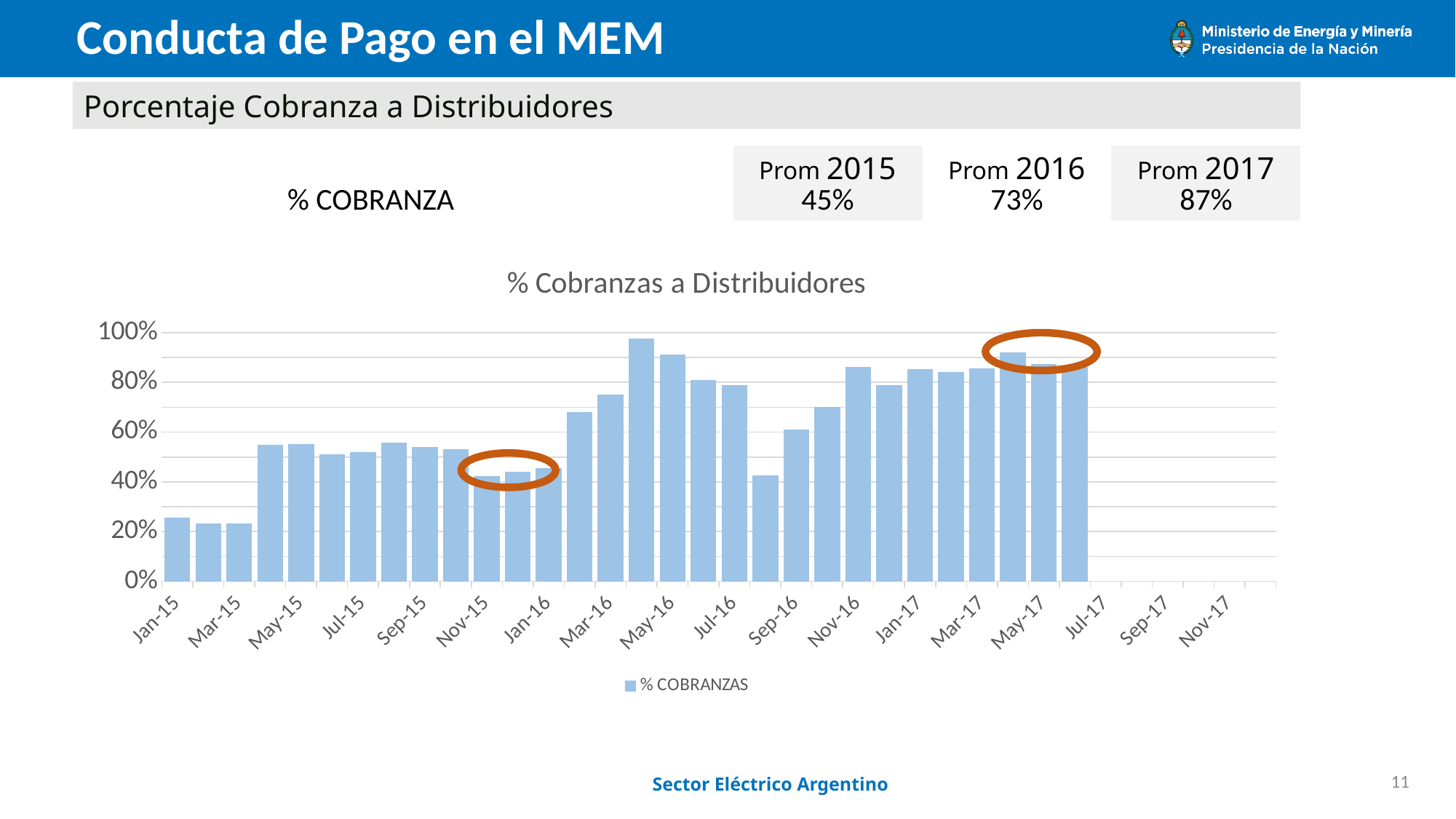
Overall, do the values rise or fall from Jan-15 to the last plotted month? rise Which is larger, the value for Mar-16 or the value for Sep-16? Mar-16 What is the legend entry of the chart? % COBRANZAS What is the title of the chart? % Cobranzas a Distribuidores Is the value for Jan-15 greater or less than 40%? less Is the value for Sep-16 greater or less than 80%? less Is the value for May-16 greater or less than 80%? greater How many series does the chart legend list? 1 What kind of chart is shown on the slide? bar chart Which is larger, the value for Jan-15 or the value for May-15? May-15